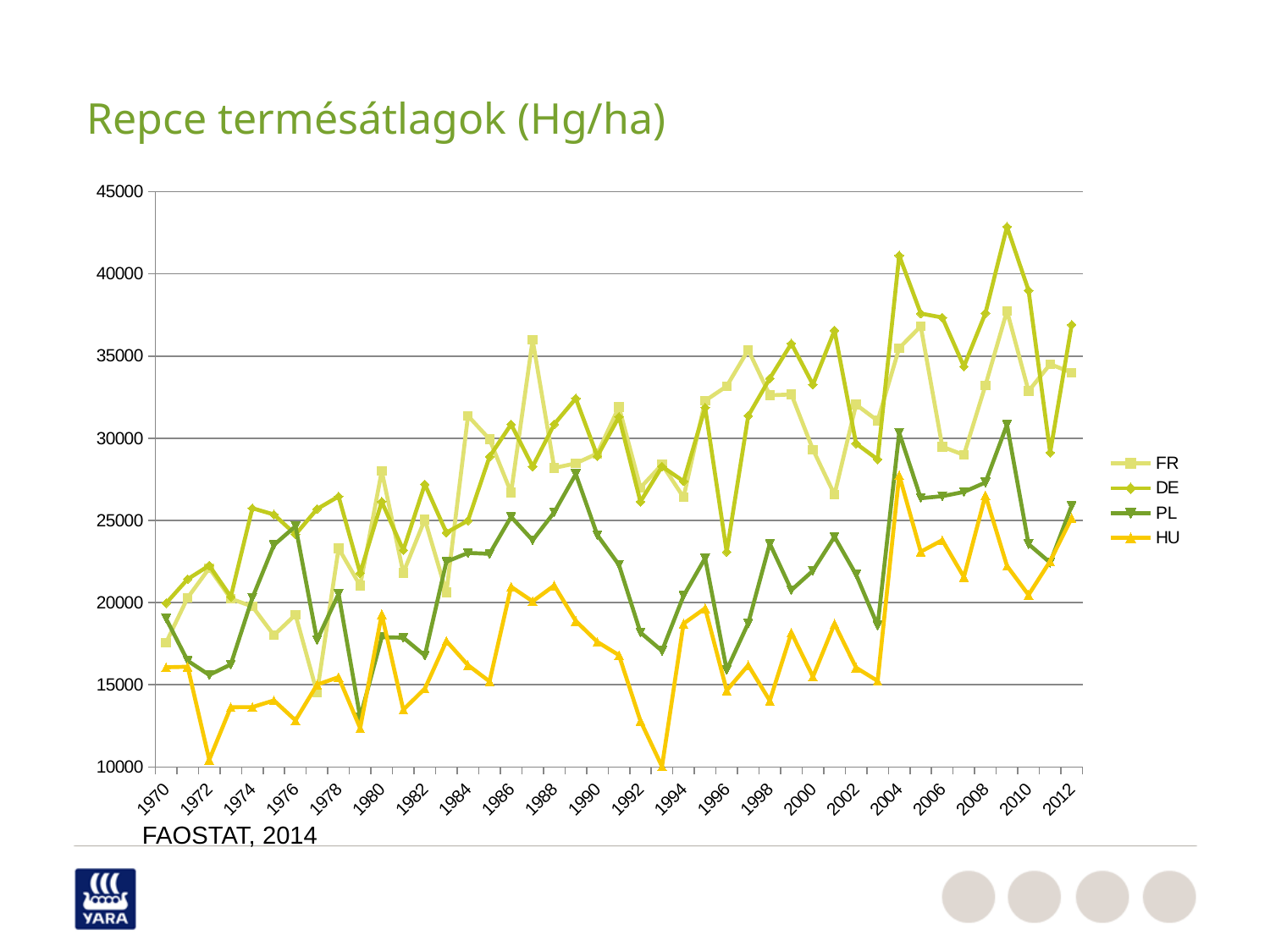
How many series does the legend list? 4 What kind of chart is shown on the slide? line chart Is the value for HU in 1993 greater or less than 15000? less What is the title of the chart? Repce termésátlagok (Hg/ha) In 2009, which is larger, the value for DE or the value for FR? DE Which series has the lowest value in 1993? HU Is the value for FR in 1987 greater or less than 30000? greater Which series are listed in the legend? FR, DE, PL, HU Which series has the highest value in 2004? DE Is the value for PL in 1979 greater or less than 15000? less